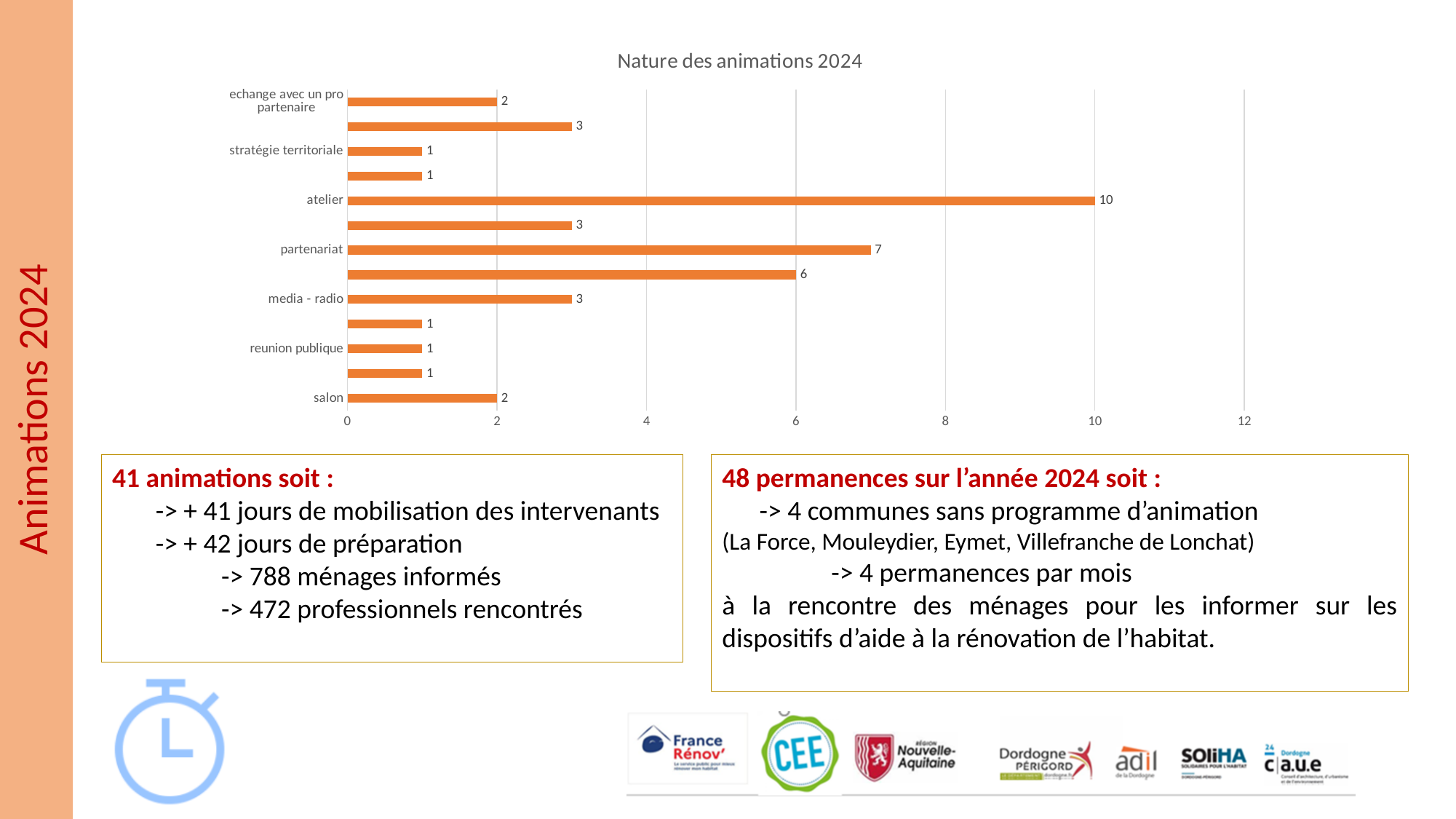
What is the value for media - radio? 3 How many bars are plotted in the chart? 13 Which is larger, the value for partenariat or the value for media - radio? partenariat What is the value for partenariat? 7 What is the value for salon? 2 What is the value for stratégie territoriale? 1 What is the value for atelier? 10 Is the value for atelier greater or less than 8? greater What is the title of the chart? Nature des animations 2024 What kind of chart is shown on the slide? bar chart What is the difference between the values for atelier and partenariat? 3 Which category has the highest value? atelier